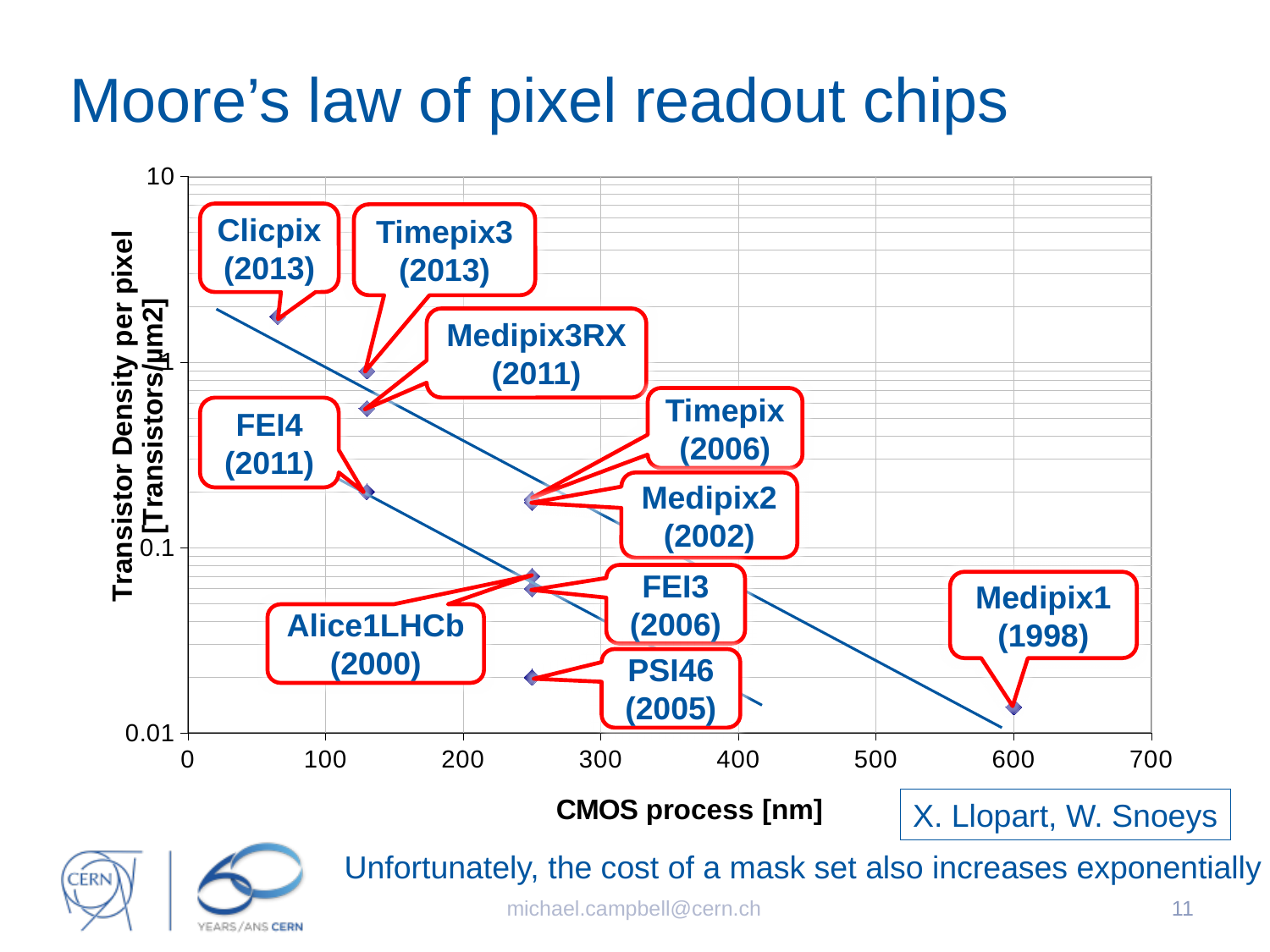
Which chip has the lowest transistor density per pixel? Medipix1 (1998) Is the transistor density for Clicpix (2013) greater or less than 1? greater Is the transistor density for Medipix1 (1998) greater or less than 0.1? less As the CMOS process node increases along the x axis, does the transistor density per pixel rise or fall? fall Which has a higher transistor density per pixel, Medipix3RX (2011) or PSI46 (2005)? Medipix3RX (2011) What kind of chart is shown on the slide? Scatter plot How many pixel readout chips are labelled on the chart? 10 What is the title of the chart on the slide? Moore's law of pixel readout chips Which chip has the highest transistor density per pixel? Clicpix (2013) Is the transistor density for FEI4 (2011) greater or less than 0.1? greater Which chip is plotted at the largest CMOS process node? Medipix1 (1998) What is the label of the x axis of the chart? CMOS process [nm]